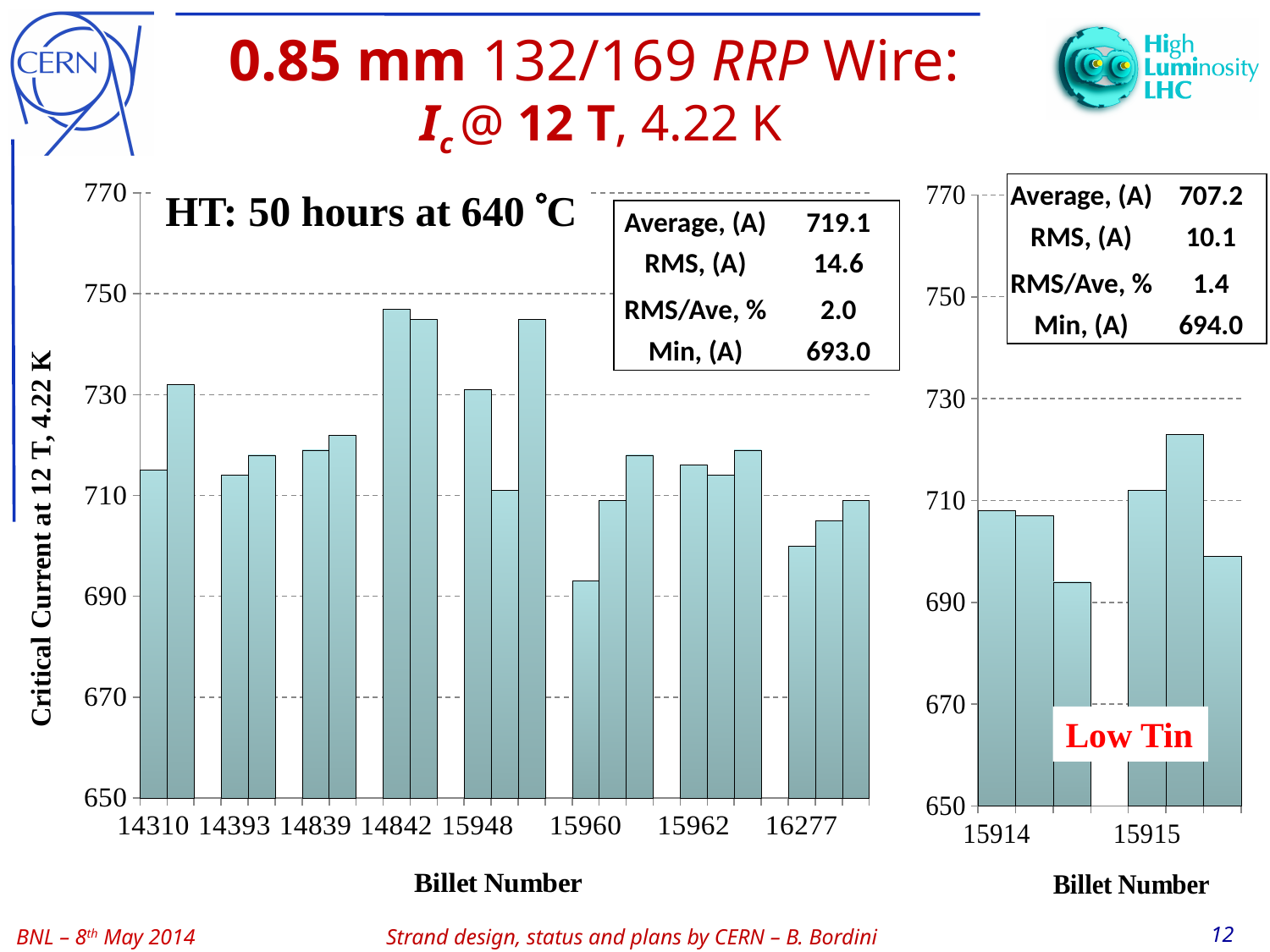
In the left chart, is the first bar for billet 15960 greater or less than 710? less In the right chart, which billet number has the tallest bar? 15915 What label is written in red inside the right chart? Low Tin In the left chart, which billet number has the lowest bar? 15960 In the right chart, is the lowest bar for billet 15914 greater or less than 710? less In the right chart, is the tallest bar for billet 15915 greater or less than 710? greater How many billet numbers are labelled on the x axis of the right chart? 2 How many billet numbers are labelled on the x axis of the left chart? 8 What kind of chart is the left chart on the slide? bar chart What is the y-axis title of the left chart? Critical Current at 12 T, 4.22 K In the left chart, which is taller: the tallest bar for billet 14310 or the tallest bar for billet 14393? 14310